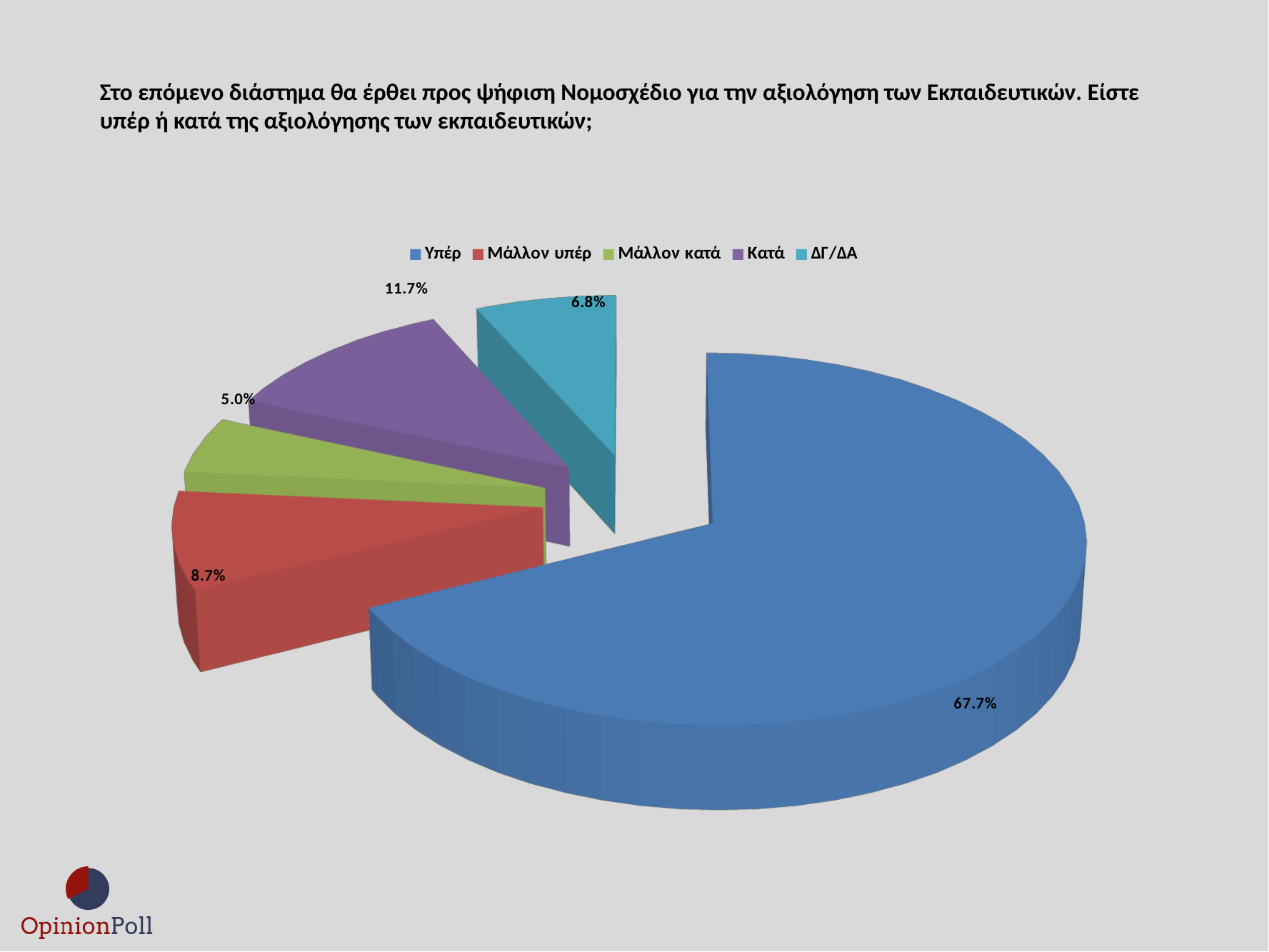
What percentage is shown for Μάλλον υπέρ? 8.7% Which category has the largest share of the pie? Υπέρ What percentage is shown for Υπέρ? 67.7% How many slices does the pie chart have? 5 What kind of chart is shown on the slide? Pie chart What percentage is shown for Μάλλον κατά? 5.0% What percentage is shown for Κατά? 11.7% Which category has the smallest share of the pie? Μάλλον κατά Which colour represents Κατά in the legend? Purple What is the difference in percentage points between Κατά and Μάλλον υπέρ? 3.0 What percentage is shown for ΔΓ/ΔΑ? 6.8% Which is larger, the share for Μάλλον υπέρ or the share for ΔΓ/ΔΑ? Μάλλον υπέρ